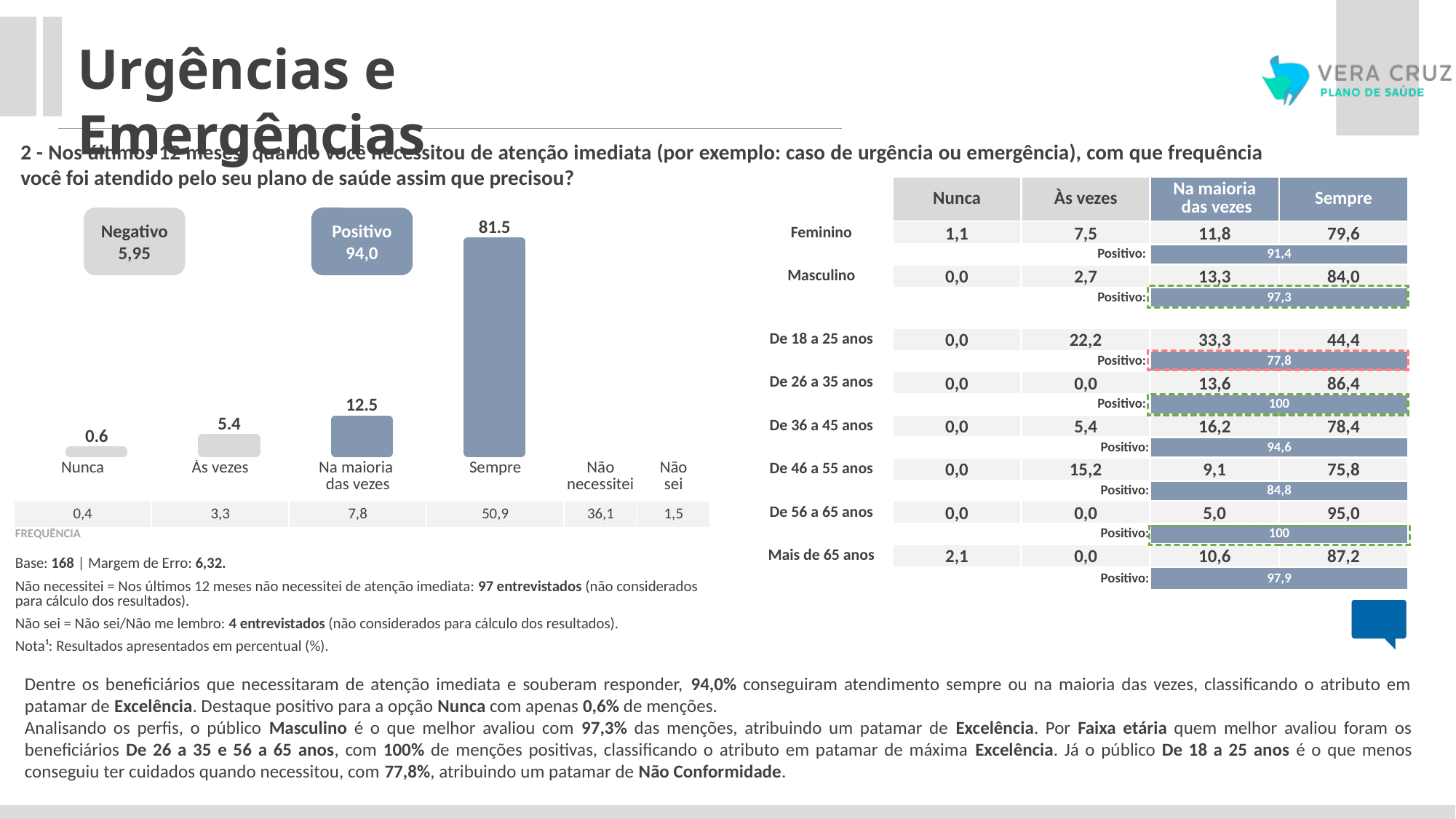
What value is shown in the "Positivo" box above the bar chart? 94,0 In the bar chart, which category has the highest value? Sempre In the bar chart, what is the value for "Sempre"? 81.5 In the bar chart, which category has the lowest plotted value? Nunca In the bar chart, what is the value for "Às vezes"? 5.4 In the bar chart, how many categories have a bar plotted? 4 In the bar chart, which is larger: the value for "Às vezes" or the value for "Na maioria das vezes"? Na maioria das vezes In the bar chart, what is the value for "Na maioria das vezes"? 12.5 In the bar chart, do the values rise or fall going from "Nunca" to "Sempre" along the x axis? rise In the bar chart, what is the value for "Nunca"? 0.6 In the bar chart, what is the difference between the values for "Sempre" and "Na maioria das vezes"? 69.0 What kind of chart is shown on the left of the slide? bar chart